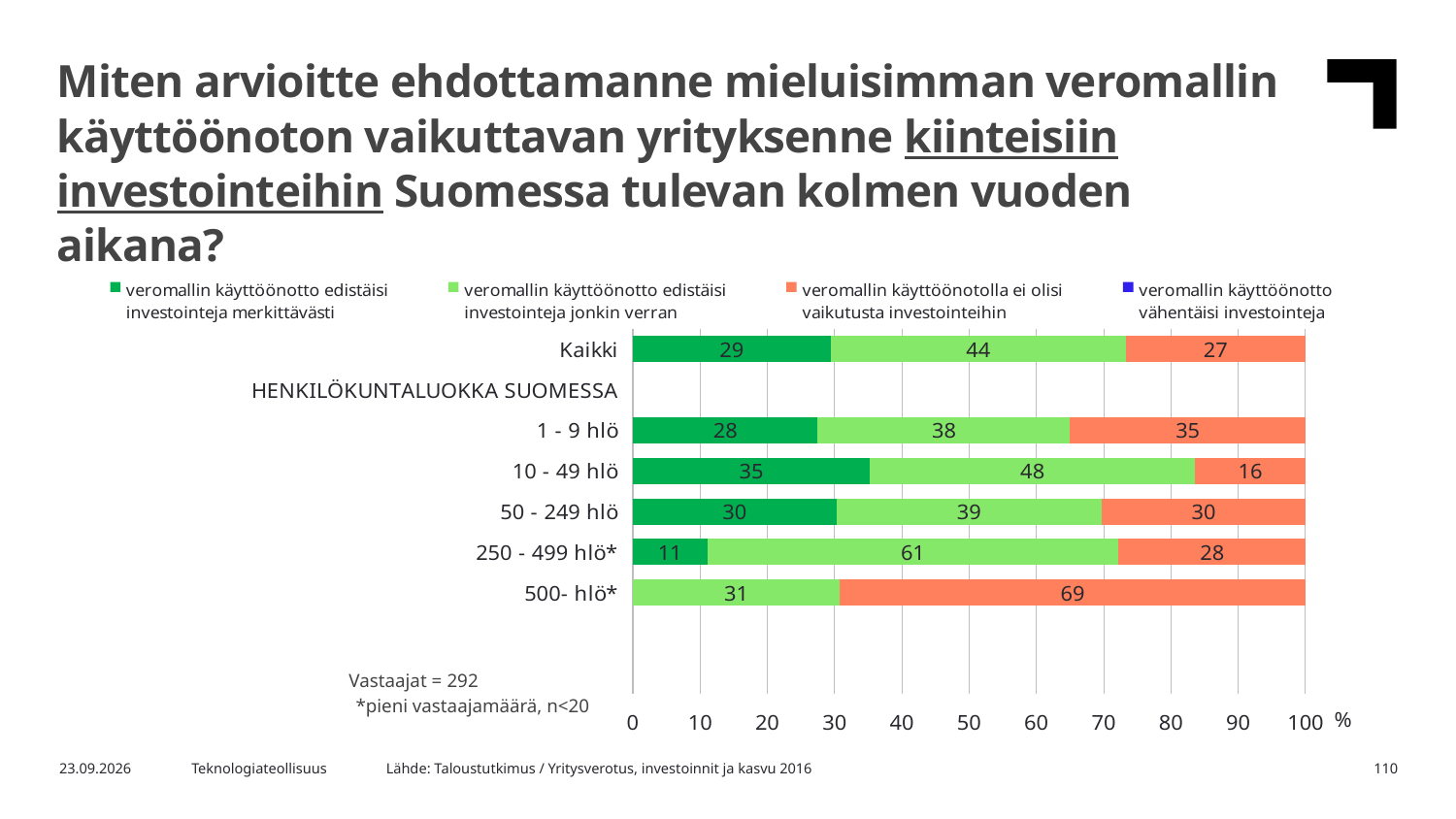
Which is larger: the 'veromallin käyttöönotto edistäisi investointeja merkittävästi' value for 50 - 249 hlö or for 250 - 499 hlö*? 50 - 249 hlö Which category has the highest value for 'veromallin käyttöönotto edistäisi investointeja jonkin verran'? 250 - 499 hlö* What kind of chart is shown on the slide? stacked bar chart What is the value of 'veromallin käyttöönotto edistäisi investointeja merkittävästi' for 10 - 49 hlö? 35 What is the value of 'veromallin käyttöönotto edistäisi investointeja jonkin verran' for Kaikki? 44 Which category has the lowest value for 'veromallin käyttöönotolla ei olisi vaikutusta investointeihin'? 10 - 49 hlö What is the difference between the 'veromallin käyttöönotolla ei olisi vaikutusta investointeihin' values for 1 - 9 hlö and 10 - 49 hlö? 19 What is the value of 'veromallin käyttöönotolla ei olisi vaikutusta investointeihin' for 500- hlö*? 69 How many size categories (excluding Kaikki) are plotted under HENKILÖKUNTALUOKKA SUOMESSA? 5 What is the number of respondents (Vastaajat) stated on the chart? 292 How many series does the legend list? 4 What is the total of the stacked bar for Kaikki? 100